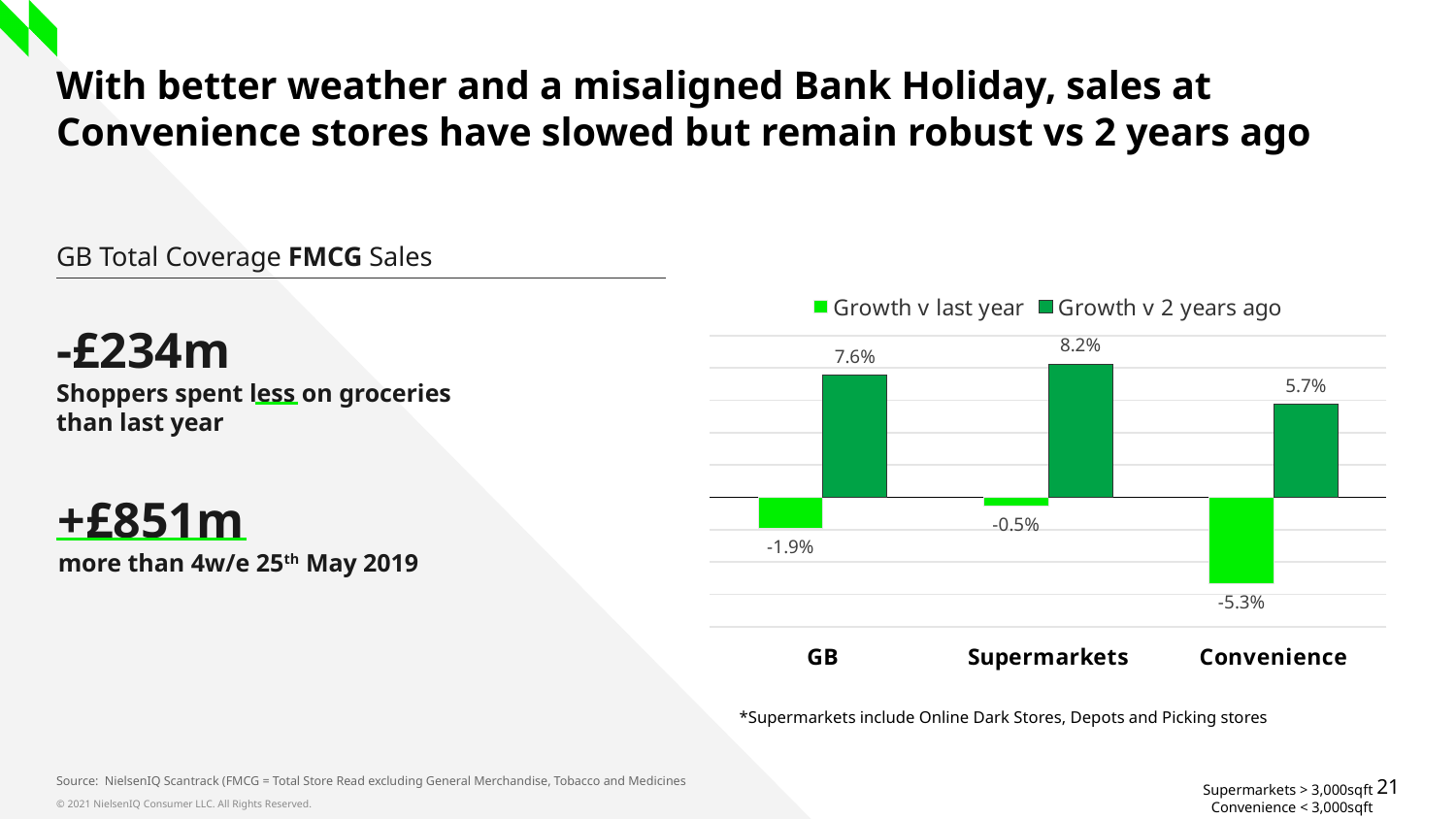
How many series does the chart legend list? 2 What is the Growth v last year value for GB? -1.9% What are the two series named in the chart legend? Growth v last year and Growth v 2 years ago Which category has the lowest Growth v last year value? Convenience How many categories are shown on the x axis of the chart? 3 Which is larger for Supermarkets: Growth v last year or Growth v 2 years ago? Growth v 2 years ago What type of chart is shown on the slide? Bar chart Which category has the highest Growth v 2 years ago value? Supermarkets What is the Growth v 2 years ago value for Convenience? 5.7% What is the Growth v 2 years ago value for Supermarkets? 8.2% What is the Growth v last year value for Convenience? -5.3% What is the difference between the Growth v 2 years ago and Growth v last year values for GB? 9.5 percentage points